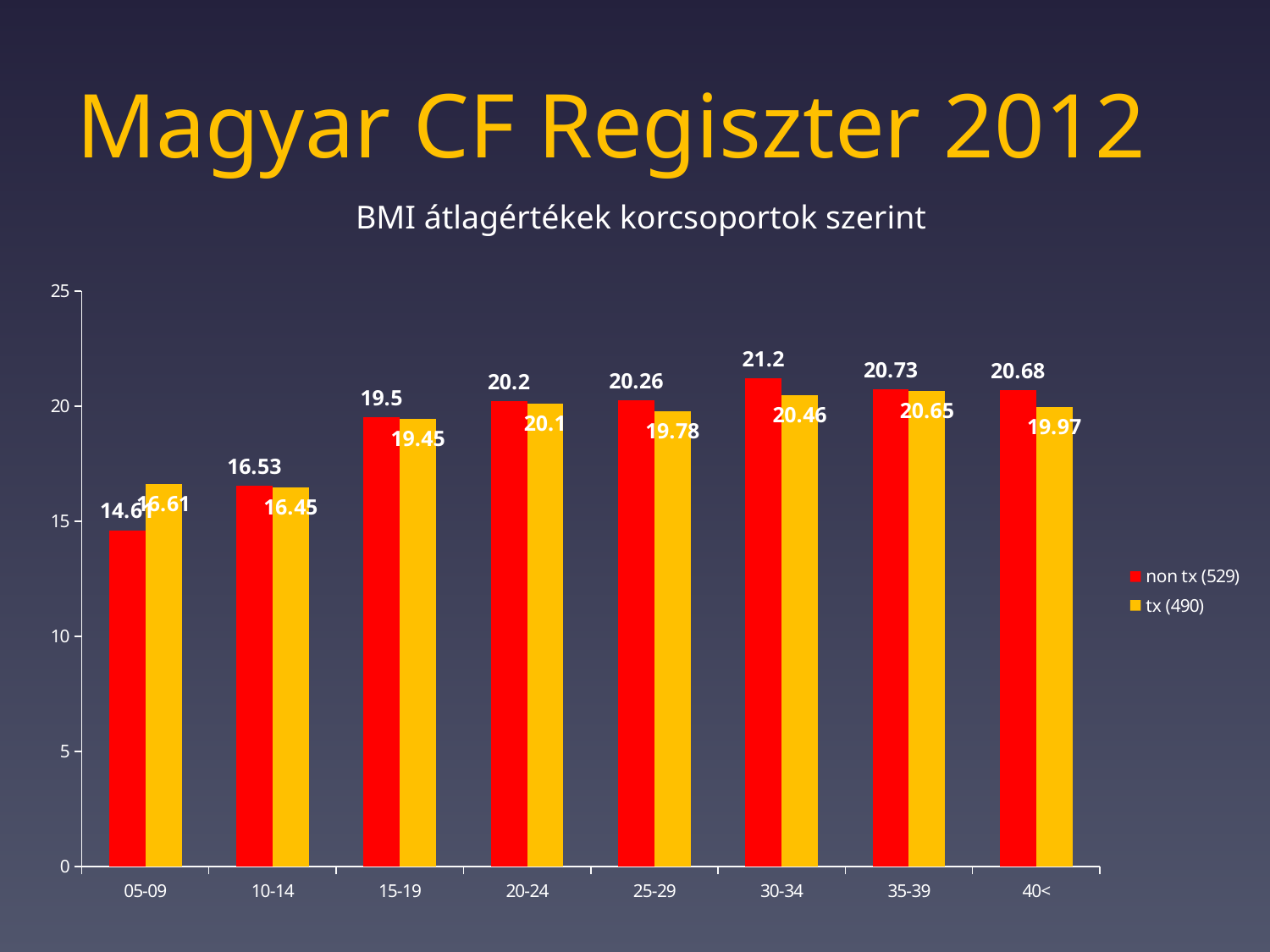
What is the value for non tx (529) in the 35-39 age group? 20.73 In the 05-09 age group, which series has the larger value, non tx (529) or tx (490)? tx (490) What is the value for tx (490) in the 25-29 age group? 19.78 Which age group has the lowest value for tx (490)? 10-14 Which age group has the highest value for non tx (529)? 30-34 How many age groups are shown on the x axis? 8 What is the difference between the non tx (529) and tx (490) values in the 30-34 age group? 0.74 How many series does the legend list? 2 What is the value for tx (490) in the 40< age group? 19.97 What is the title of the chart? BMI átlagértékek korcsoportok szerint What kind of chart is shown on the slide? bar chart What is the value for non tx (529) in the 30-34 age group? 21.2